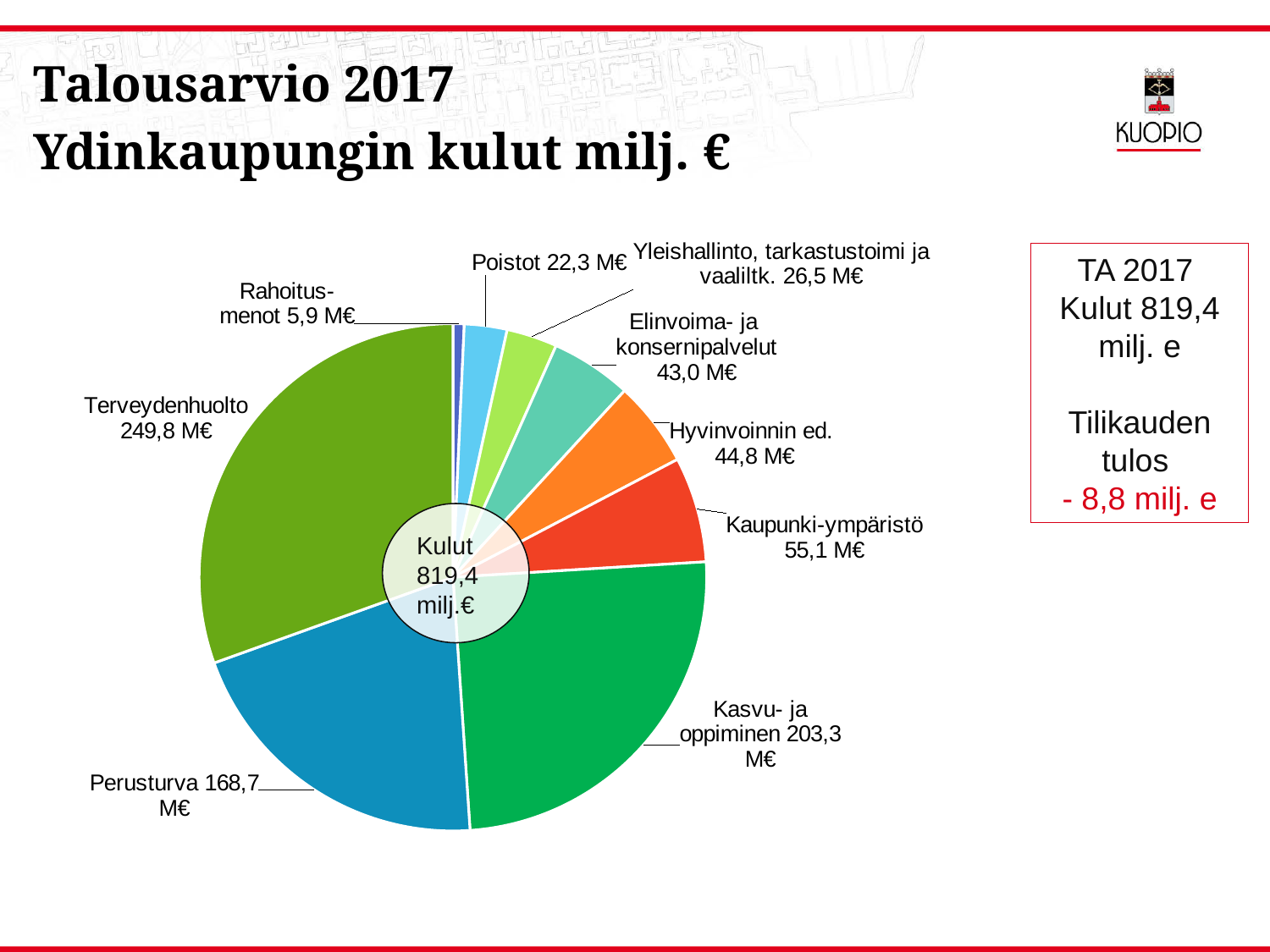
How many slices does the pie chart have? 9 What kind of chart is shown on the slide? Pie chart What is the title of the slide? Talousarvio 2017 Ydinkaupungin kulut milj. € What is the value for Poistot? 22,3 M€ Which category has the largest slice of the pie? Terveydenhuolto What is the value for Kasvu- ja oppiminen? 203,3 M€ What is the value for Terveydenhuolto? 249,8 M€ What total is shown in the centre of the pie chart? Kulut 819,4 milj.€ Which is larger, Perusturva or Kasvu- ja oppiminen? Kasvu- ja oppiminen What is the value for Kaupunki-ympäristö? 55,1 M€ Which category has the smallest slice of the pie? Rahoitusmenot What is the difference between Terveydenhuolto and Kasvu- ja oppiminen? 46,5 M€